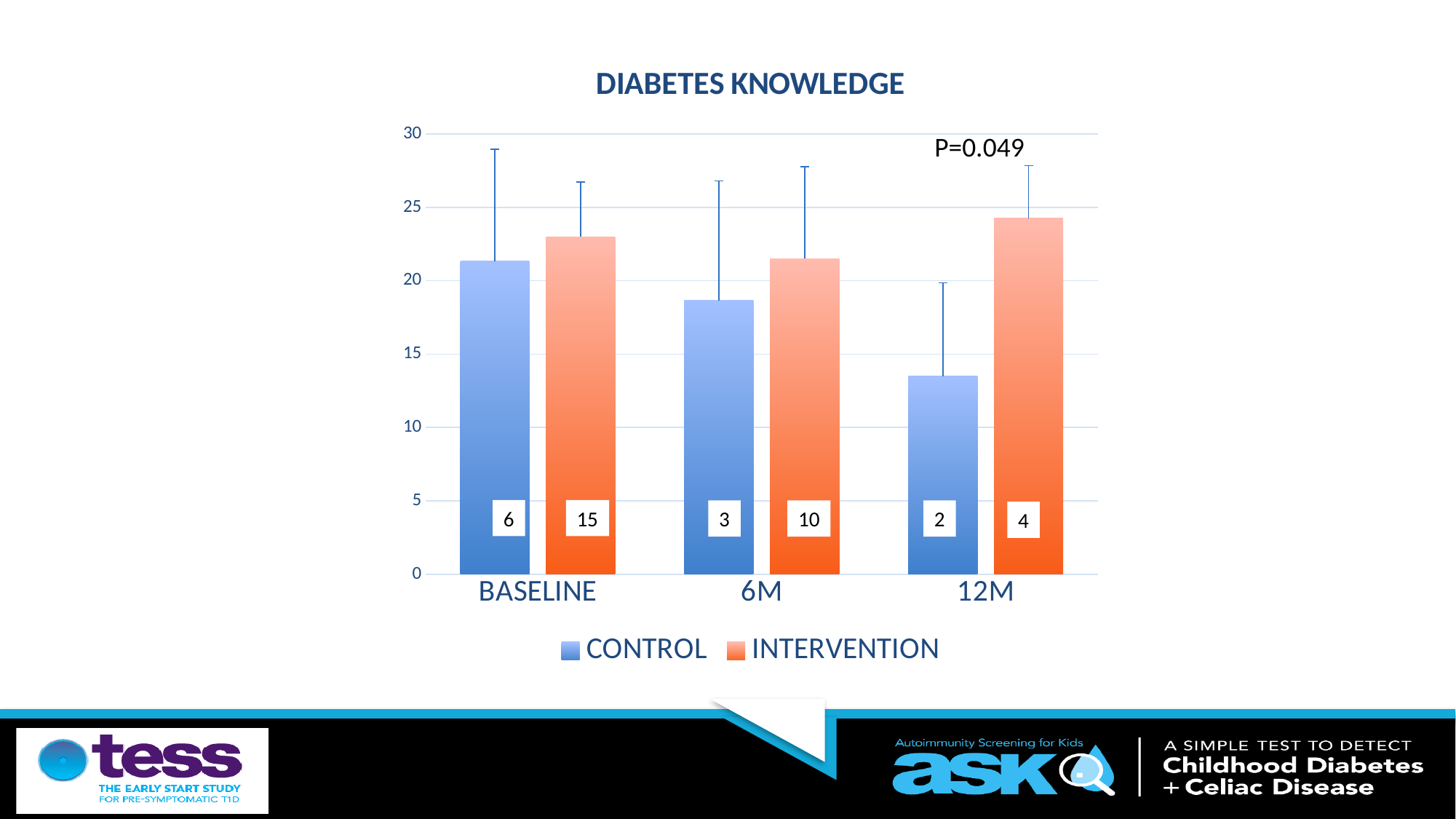
What kind of chart is shown on the slide? bar chart Is the INTERVENTION value at BASELINE greater or less than 20? greater Do the CONTROL values rise or fall from BASELINE to 12M? fall How many series does the legend list? 2 How many categories are shown on the x axis? 3 Is the INTERVENTION value at 12M greater or less than 20? greater What is the title of the chart? DIABETES KNOWLEDGE Is the CONTROL value at 12M greater or less than 15? less At 12M, which series has the larger value, CONTROL or INTERVENTION? INTERVENTION Which category has the lowest CONTROL bar? 12M What P value is annotated above the 12M bars? P=0.049